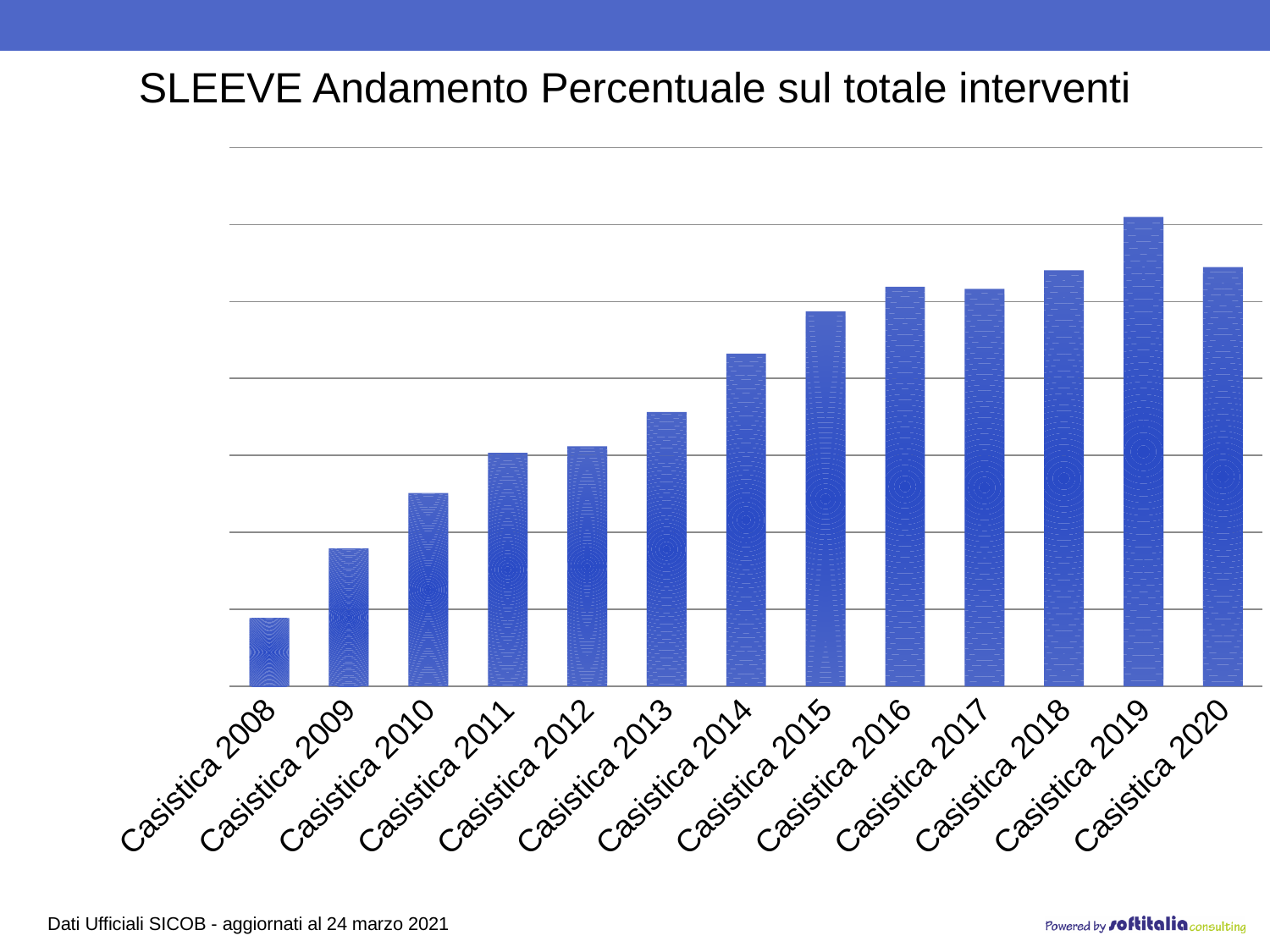
Which category has the highest bar? Casistica 2019 Which category has the lowest bar? Casistica 2008 What colour are the bars in the chart? blue Does the value rise or fall from Casistica 2019 to Casistica 2020? fall Which is larger, the value for Casistica 2009 or Casistica 2010? Casistica 2010 Do the values generally rise or fall from Casistica 2008 to Casistica 2019? rise How many categories (bars) are plotted in the chart? 13 Which is larger, the value for Casistica 2013 or Casistica 2014? Casistica 2014 Which is larger, the value for Casistica 2012 or Casistica 2015? Casistica 2015 What is the title of the chart? SLEEVE Andamento Percentuale sul totale interventi What kind of chart is shown on the slide? bar chart